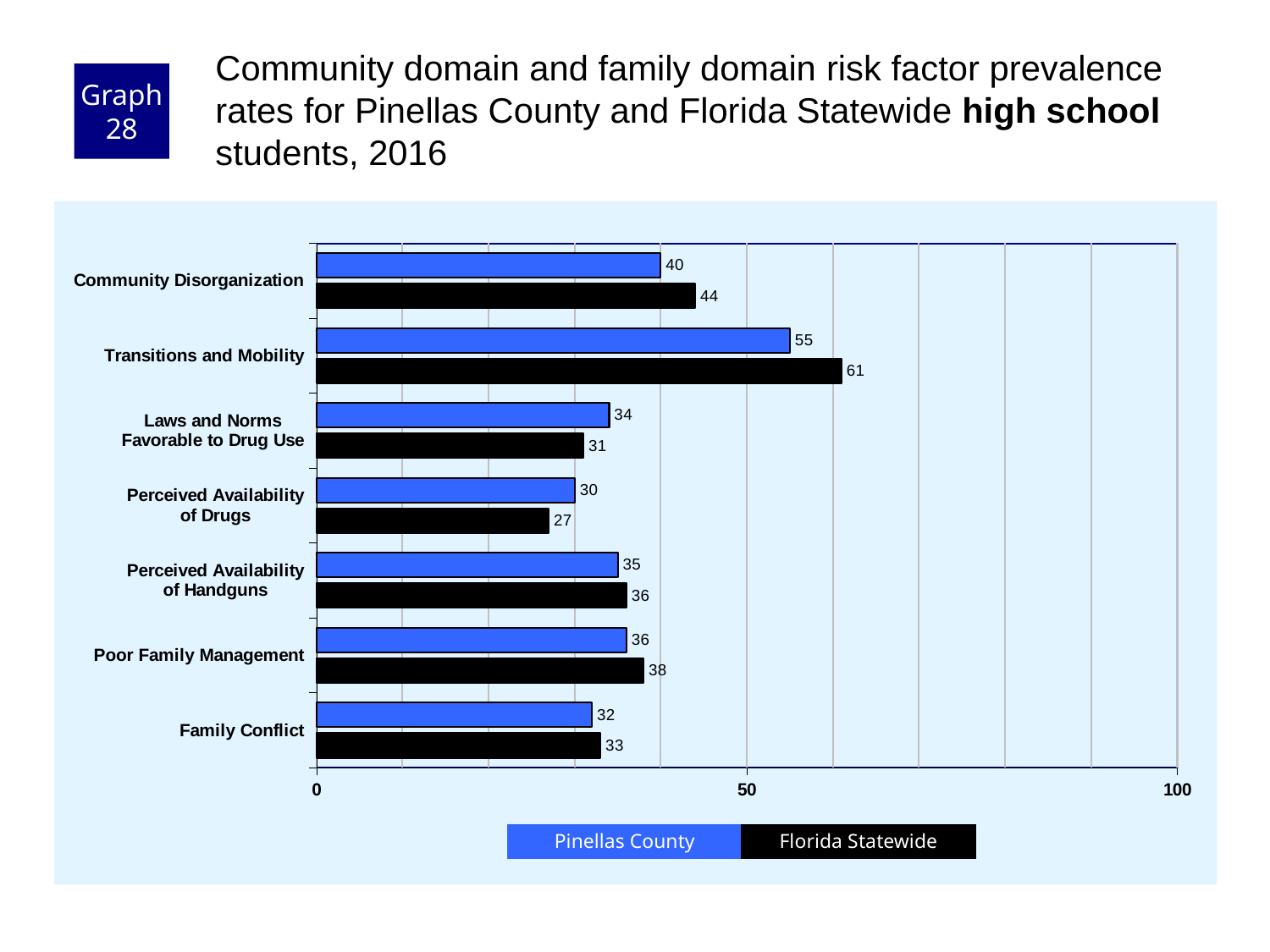
Which risk factor has the lowest Pinellas County value? Perceived Availability of Drugs Which colour represents Florida Statewide in the legend? Black Is the Florida Statewide value for Transitions and Mobility greater or less than 50? greater How many series does the legend list? 2 What kind of chart is shown on the slide? Bar chart What is the Florida Statewide value for Community Disorganization? 44 What is the difference between the Florida Statewide and Pinellas County values for Transitions and Mobility? 6 Which is larger for Laws and Norms Favorable to Drug Use: the Pinellas County value or the Florida Statewide value? Pinellas County What is the Pinellas County value for Transitions and Mobility? 55 How many risk factor categories are shown on the chart? 7 Which risk factor has the highest Florida Statewide value? Transitions and Mobility What is the Florida Statewide value for Perceived Availability of Drugs? 27